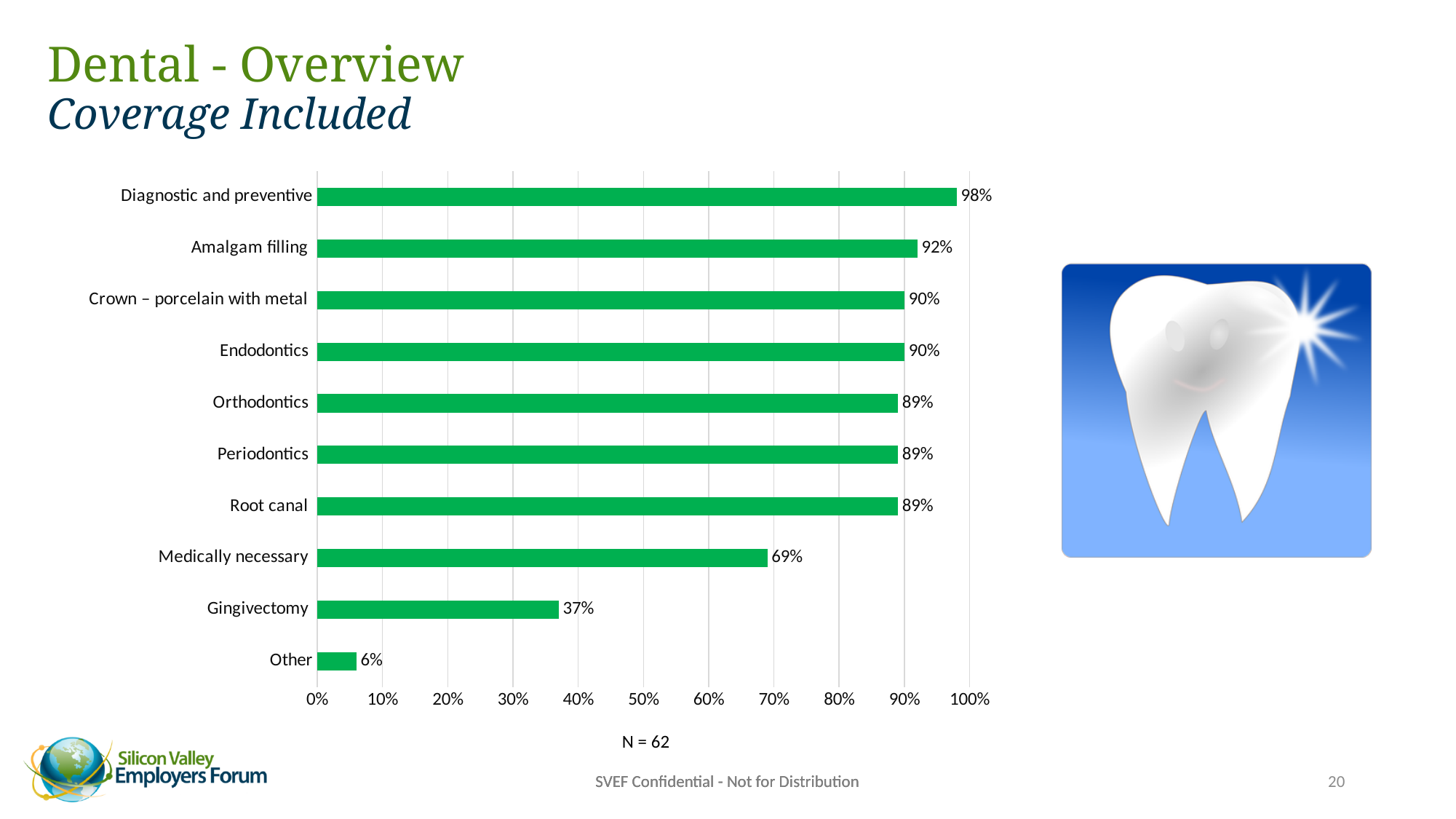
What percentage is shown for Medically necessary? 69% Which category has the highest value? Diagnostic and preventive What is the difference between the values for Diagnostic and preventive and Other? 92% Is the value for Endodontics greater or less than 80%? greater What is the difference between the values for Amalgam filling and Medically necessary? 23% Which category has the lowest value? Other What kind of chart is shown on the slide? bar chart How many categories are shown in the chart? 10 What is the sample size noted below the chart? N = 62 What is the value for Gingivectomy? 37% Which is larger, the value for Gingivectomy or the value for Medically necessary? Medically necessary What percentage is shown for Diagnostic and preventive? 98%